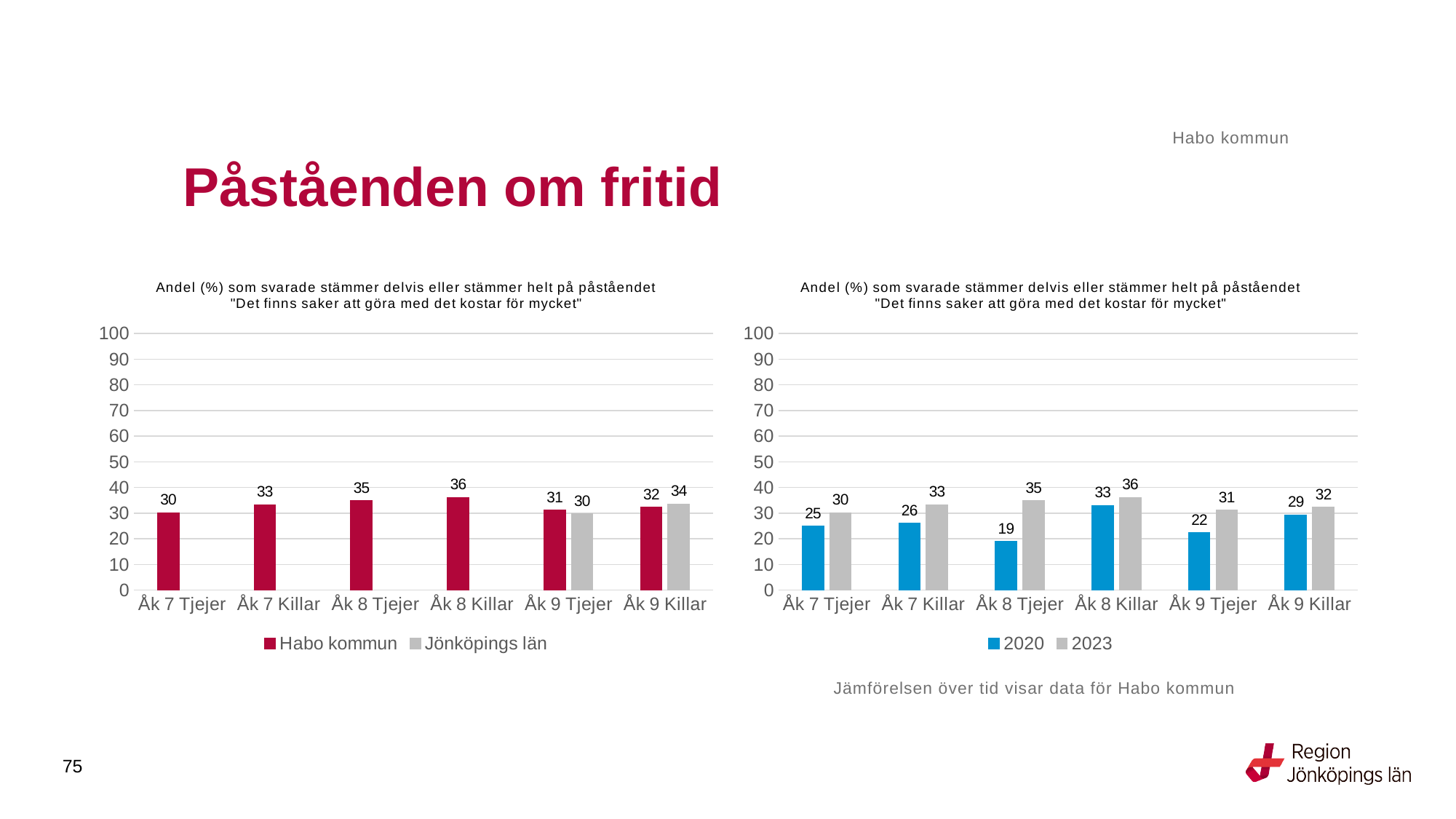
In the right chart, which category has the lowest 2020 value? Åk 8 Tjejer What type of chart is the right chart? bar chart In the right chart, what is the 2023 value for Åk 9 Tjejer? 31 In the left chart, which category has the lowest Habo kommun value? Åk 7 Tjejer In the left chart, what is the value for Habo kommun for Åk 8 Killar? 36 In the left chart, what is the difference between the Habo kommun and Jönköpings län values for Åk 9 Killar? 2 In the right chart, what is the difference between the 2023 and 2020 values for Åk 8 Tjejer? 16 In the right chart, is the 2020 value for Åk 8 Killar larger or smaller than the 2023 value for Åk 8 Killar? smaller In the left chart, which category has the highest Habo kommun value? Åk 8 Killar In the left chart, what is the value for Jönköpings län for Åk 9 Killar? 34 In the left chart, how many series does the legend list? 2 In the right chart, what is the 2020 value for Åk 8 Tjejer? 19